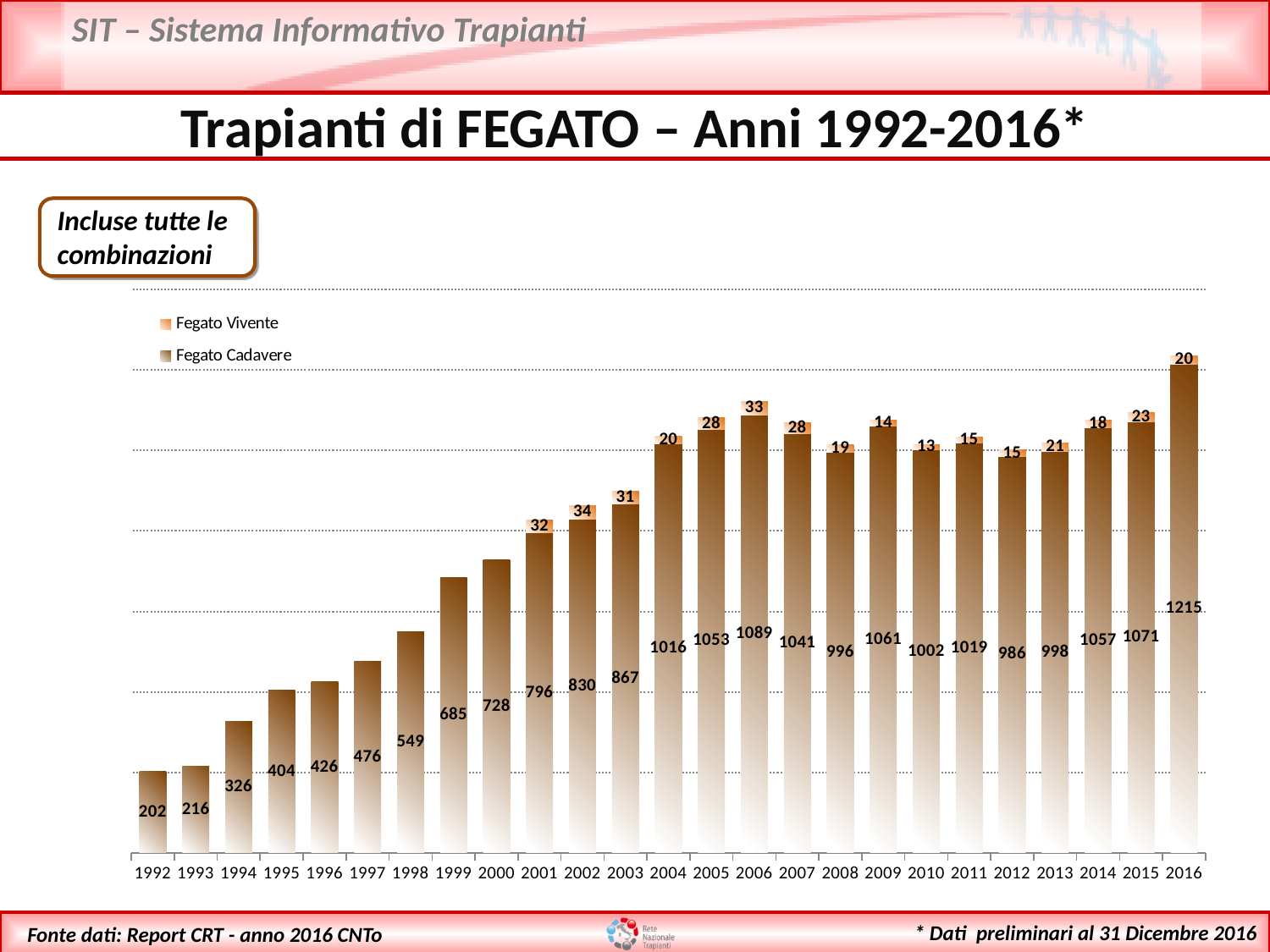
What kind of chart is shown on the slide? Stacked bar chart Which year has the highest Fegato Vivente value? 2002 What is the Fegato Cadavere value for 2016? 1215 How many series does the legend list? 2 What is the Fegato Cadavere value for 1992? 202 Which year has the highest Fegato Cadavere value? 2016 What is the difference between the Fegato Cadavere values for 2016 and 2015? 144 What is the total of the stacked bar for 2016? 1235 How many years are shown on the x axis? 25 What is the Fegato Vivente value for 2002? 34 Which is larger, the Fegato Cadavere value for 2006 or for 2009? 2006 Which year has the lowest Fegato Cadavere value? 1992